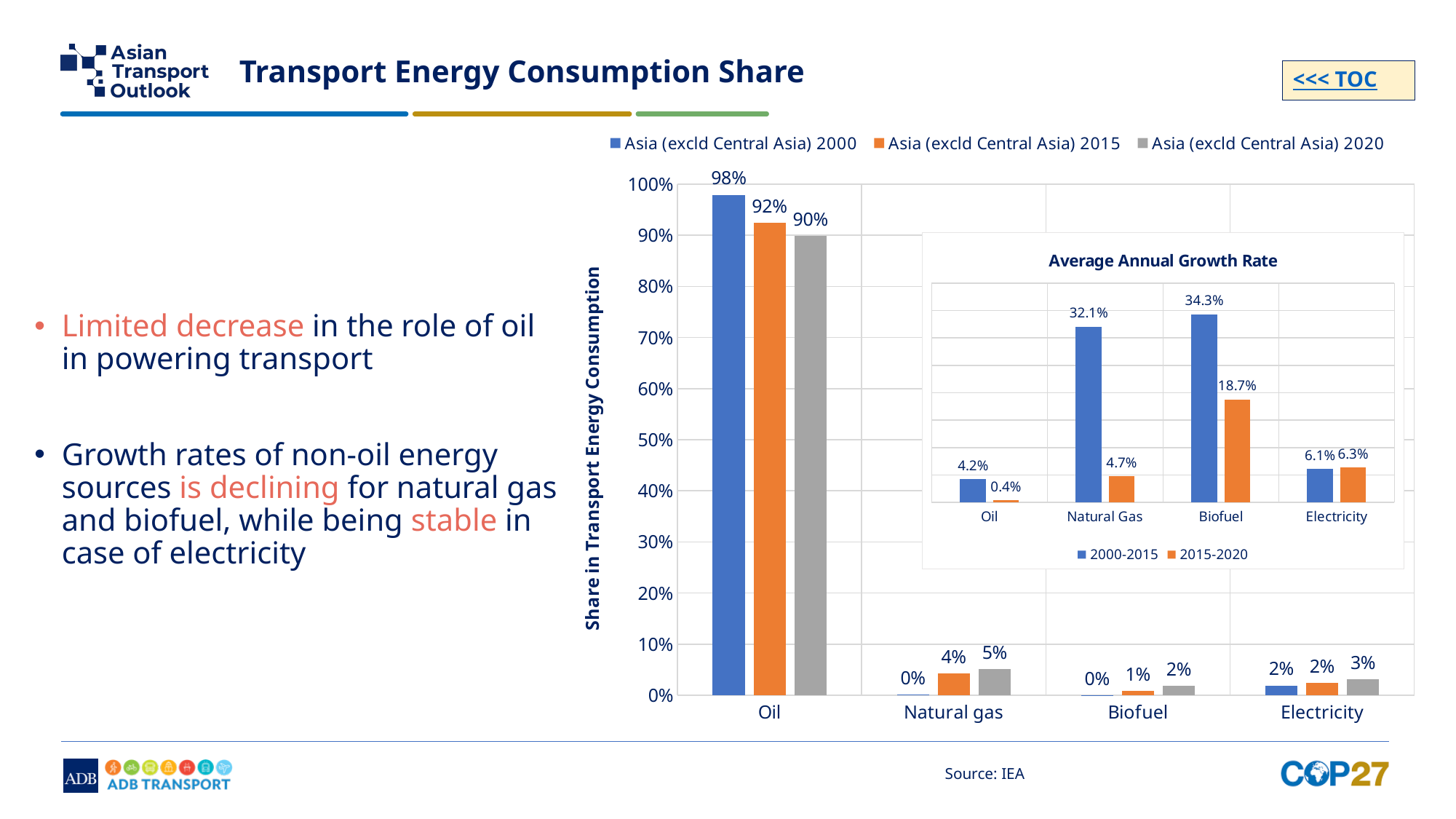
In the Average Annual Growth Rate chart, what is the growth rate for oil in 2015-2020? 0.4% In the Average Annual Growth Rate chart, what is the growth rate for biofuel in 2000-2015? 34.3% In the main share chart, by how many percentage points did the oil share fall between 2000 and 2020? 8 percentage points In the main share chart, how many energy source categories are shown on the x axis? 4 In the main share chart, what is the share of oil in transport energy consumption for Asia (excld Central Asia) in 2000? 98% In the main share chart, does the share of natural gas rise or fall from 2000 to 2020? Rise In the main share chart, what is the share of natural gas for Asia (excld Central Asia) in 2020? 5% What kind of chart is the Average Annual Growth Rate chart? Bar chart In the Average Annual Growth Rate chart, which is larger for natural gas: the 2000-2015 rate or the 2015-2020 rate? 2000-2015 In the main share chart, how many series does the legend list? 3 In the main share chart, which energy source has the highest share in 2020? Oil In the Average Annual Growth Rate chart, which category has the highest growth rate for 2000-2015? Biofuel